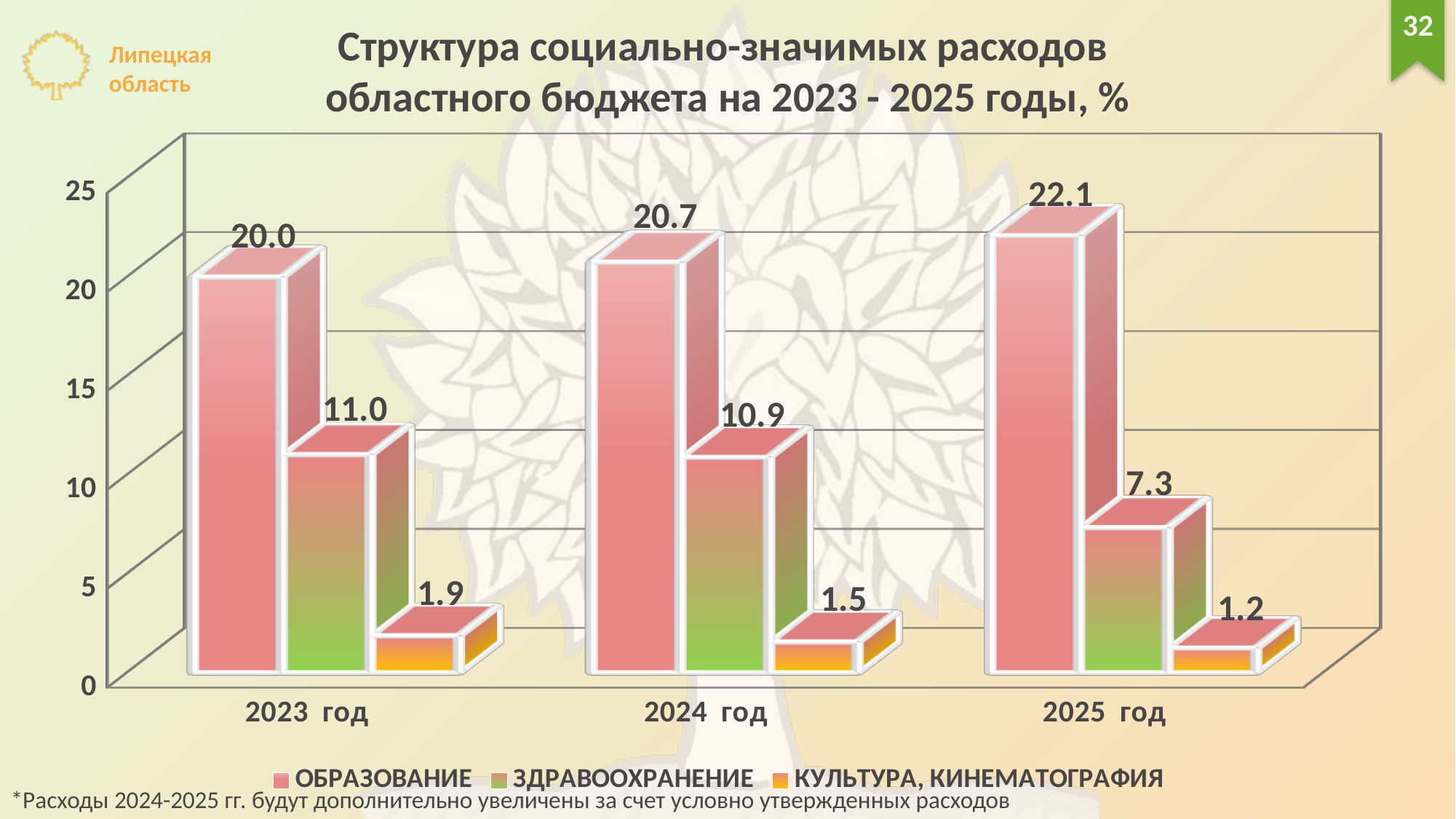
How many series does the legend list? 3 What is the value for ЗДРАВООХРАНЕНИЕ in 2025 год? 7.3 How many years are shown on the x axis? 3 Which is larger: ЗДРАВООХРАНЕНИЕ in 2023 год or in 2024 год? 2023 год In which year is the value for ОБРАЗОВАНИЕ highest? 2025 год What kind of chart is shown on the slide? bar chart What is the value for КУЛЬТУРА, КИНЕМАТОГРАФИЯ in 2024 год? 1.5 In which year is the value for ЗДРАВООХРАНЕНИЕ lowest? 2025 год Is the value for ОБРАЗОВАНИЕ in 2024 год greater or less than 20? greater What is the difference between the ОБРАЗОВАНИЕ values for 2025 год and 2023 год? 2.1 What is the value for ОБРАЗОВАНИЕ in 2023 год? 20.0 Does the value for КУЛЬТУРА, КИНЕМАТОГРАФИЯ rise or fall from 2023 год to 2025 год? fall